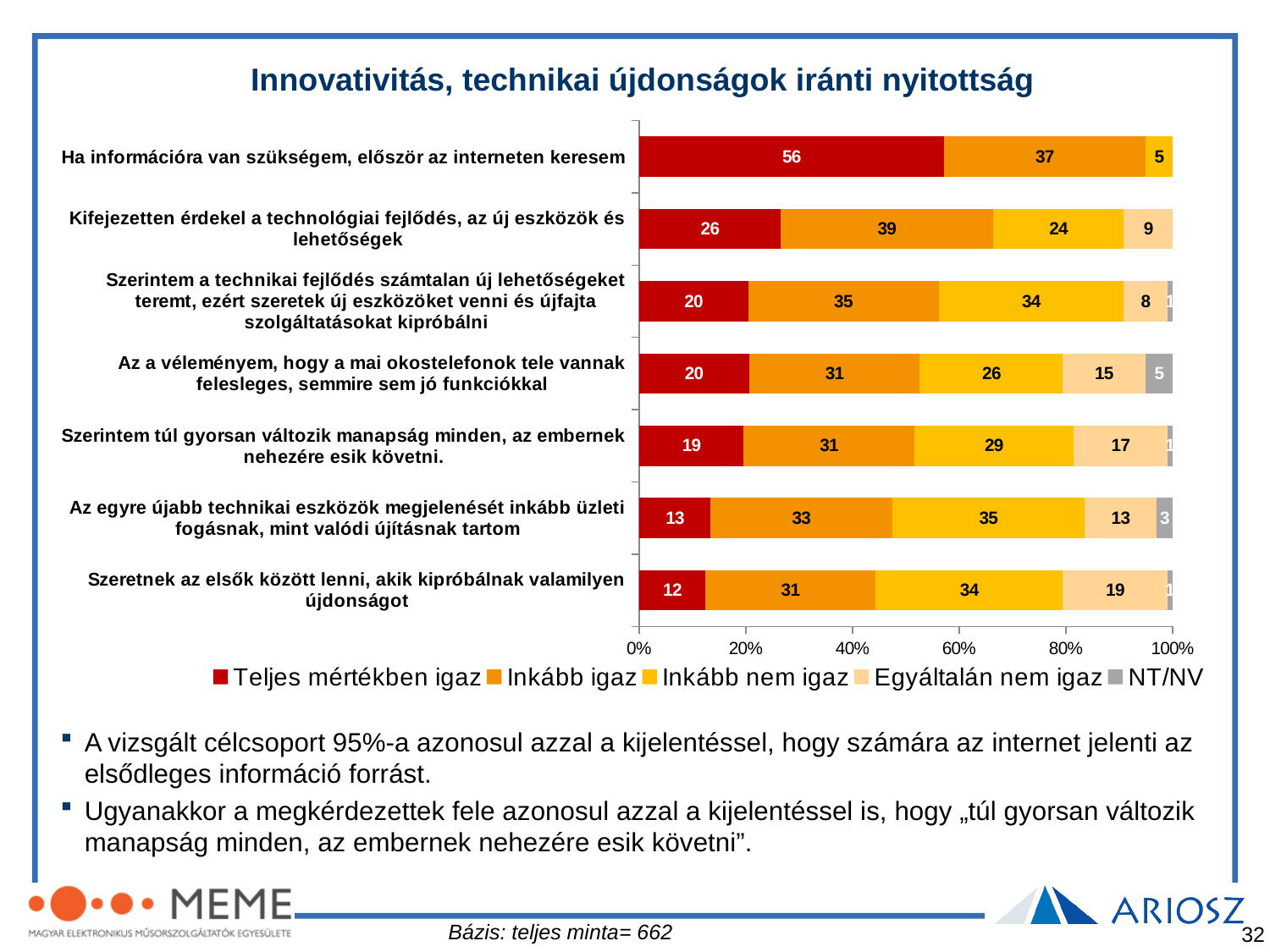
What is the 'Teljes mértékben igaz' value for 'Ha információra van szükségem, először az interneten keresem'? 56 Which statement has the lowest 'Teljes mértékben igaz' value? Szeretnek az elsők között lenni, akik kipróbálnak valamilyen újdonságot What is the 'Egyáltalán nem igaz' value for 'Szeretnek az elsők között lenni, akik kipróbálnak valamilyen újdonságot'? 19 What is the title of the chart? Innovativitás, technikai újdonságok iránti nyitottság Which is larger: the 'Inkább igaz' value for 'Kifejezetten érdekel a technológiai fejlődés, az új eszközök és lehetőségek' or for 'Szeretnek az elsők között lenni, akik kipróbálnak valamilyen újdonságot'? Kifejezetten érdekel a technológiai fejlődés, az új eszközök és lehetőségek What is the 'NT/NV' value for 'Az a véleményem, hogy a mai okostelefonok tele vannak felesleges, semmire sem jó funkciókkal'? 5 What type of chart is shown on the slide? Stacked bar chart What is the 'Inkább nem igaz' value for 'Az egyre újabb technikai eszközök megjelenését inkább üzleti fogásnak, mint valódi újításnak tartom'? 35 For 'Ha információra van szükségem, először az interneten keresem', what is the difference between the 'Teljes mértékben igaz' and 'Inkább igaz' values? 19 How many series does the legend list? 5 Which statement has the highest 'Teljes mértékben igaz' value? Ha információra van szükségem, először az interneten keresem How many statements (categories) are plotted in the chart? 7